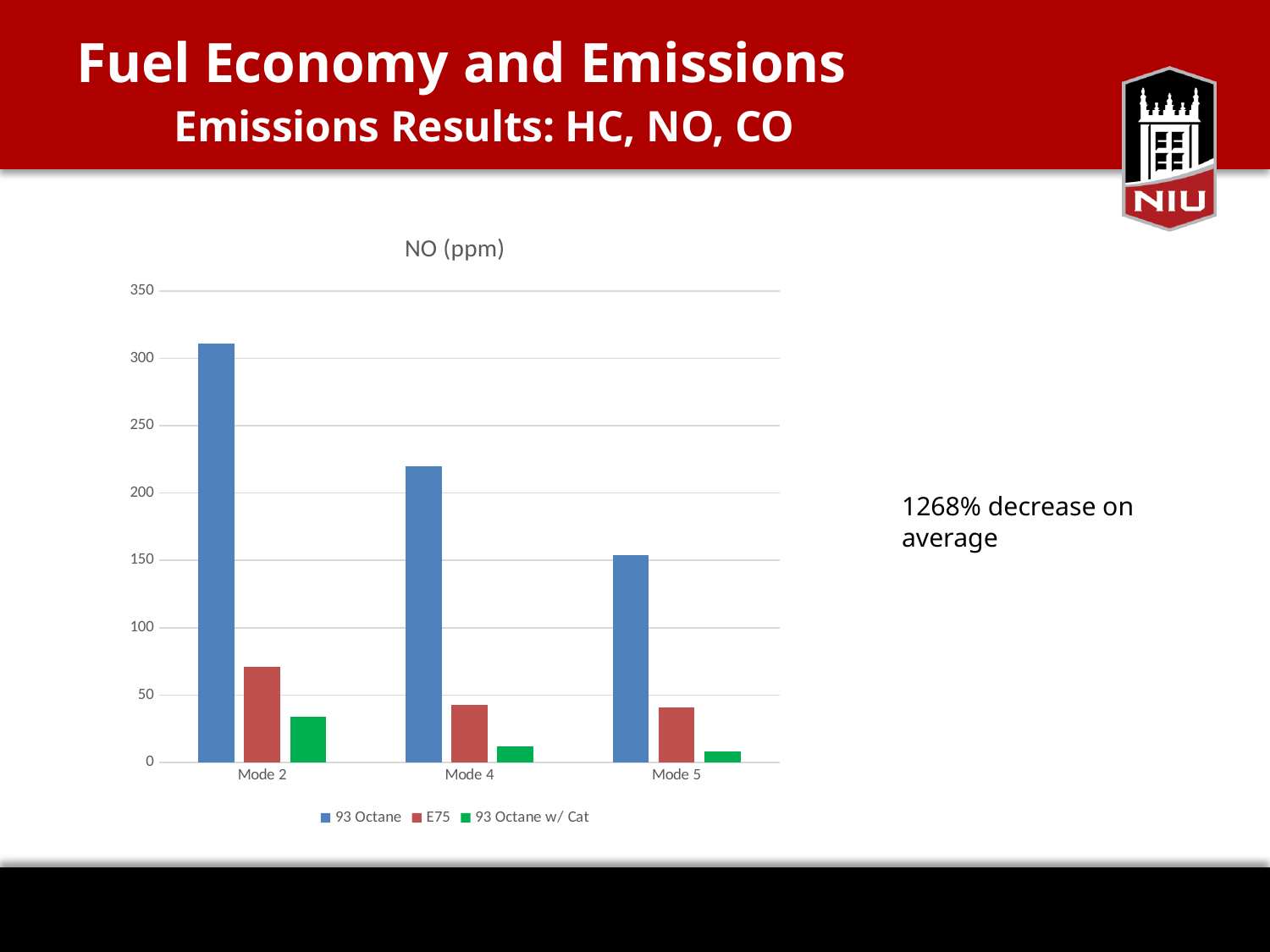
Which is larger for Mode 4: the E75 value or the 93 Octane w/ Cat value? E75 Do the 93 Octane values rise or fall from Mode 2 to Mode 5? fall Is the 93 Octane value for Mode 4 greater or less than 200? greater What is the title of the chart? NO (ppm) How many categories (modes) are shown on the x axis? 3 Is the E75 value for Mode 2 greater or less than 50? greater Is the 93 Octane value for Mode 2 greater or less than 300? greater How many series does the legend list? 3 Which mode has the lowest 93 Octane value? Mode 5 What kind of chart is shown on the slide? bar chart Which mode has the highest 93 Octane value? Mode 2 Which series is shown in green in the legend? 93 Octane w/ Cat